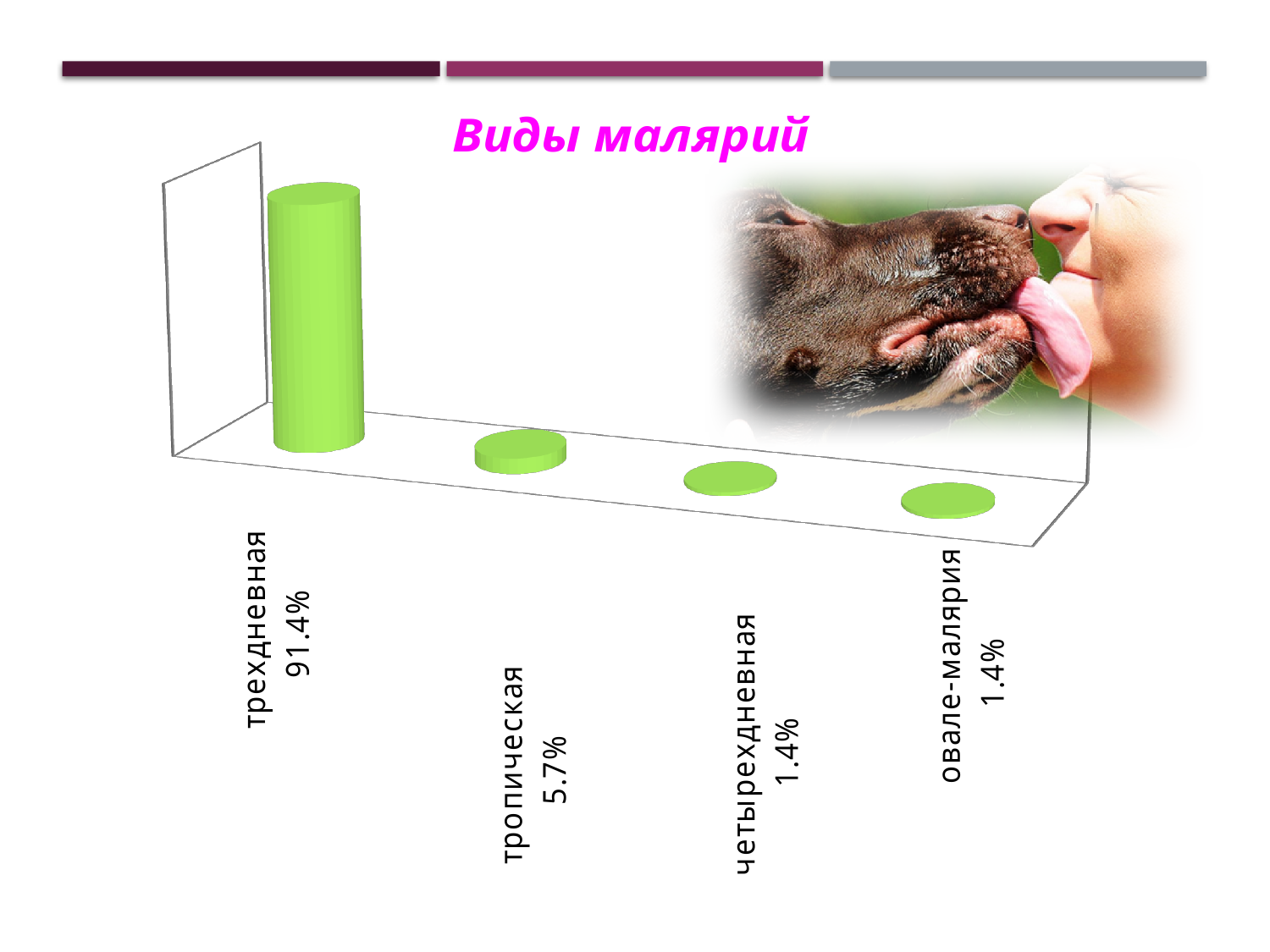
What is the value for овале-малярия? 1.4% What is the value for тропическая? 5.7% What kind of chart is shown on the slide? bar chart What is the difference between the values for трехдневная and тропическая? 85.7% What is the value for трехдневная? 91.4% How many categories are shown in the chart? 4 What is the title of the chart? Виды малярий What is the value for четырехдневная? 1.4% Which is larger, the value for тропическая or the value for овале-малярия? тропическая Which category has the highest value? трехдневная Do the values rise or fall from left to right along the x axis? fall What is the difference between the values for тропическая and четырехдневная? 4.3%